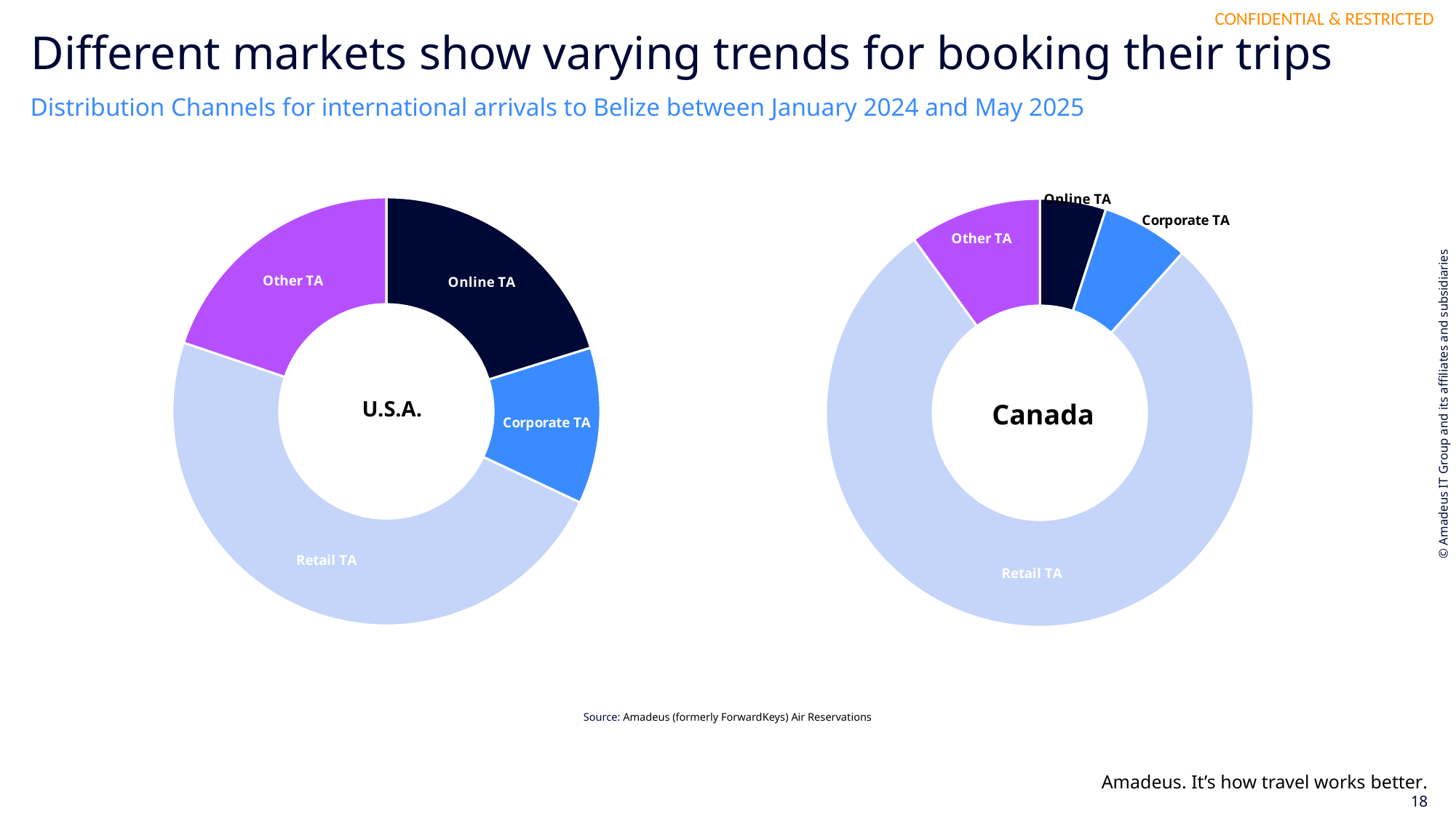
What kind of chart is the U.S.A. chart? Donut (pie) chart In the U.S.A. chart, which distribution channel has the largest share? Retail TA In the U.S.A. chart, which distribution channel has the smallest share? Corporate TA In the U.S.A. chart, which is larger: Retail TA or Online TA? Retail TA How many distribution channel segments does the Canada chart show? 4 How many distribution channel segments does the U.S.A. chart show? 4 In the Canada chart, which is larger: Retail TA or Corporate TA? Retail TA What is the subtitle describing the two charts? Distribution Channels for international arrivals to Belize between January 2024 and May 2025 In the Canada chart, which distribution channel has the largest share? Retail TA What kind of chart is the Canada chart? Donut (pie) chart What is the source cited for the charts? Amadeus (formerly ForwardKeys) Air Reservations In the Canada chart, which is larger: Other TA or Online TA? Other TA